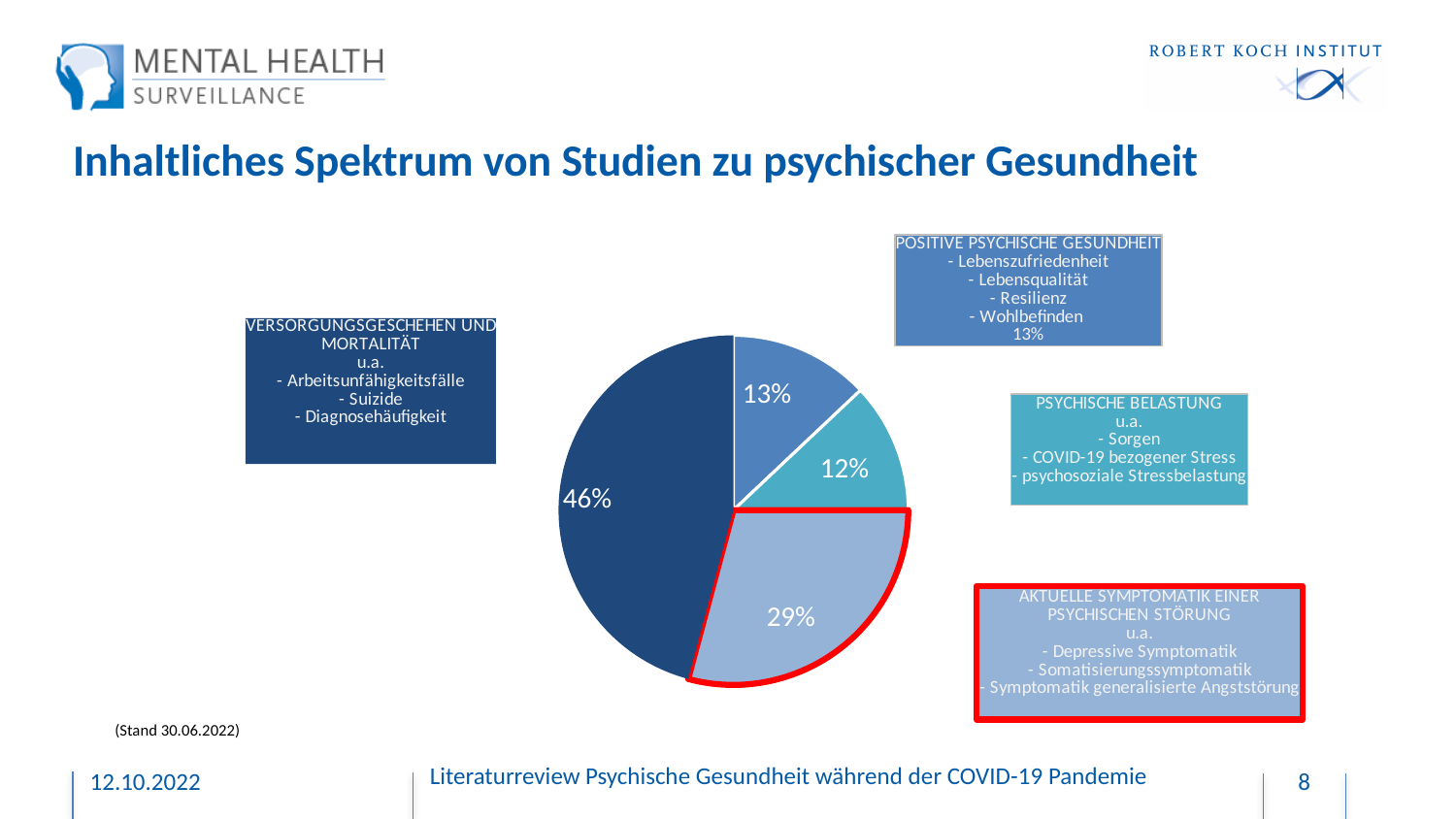
What share of the pie is labelled 'Psychische Belastung'? 12% What is the difference in percentage points between the 'Versorgungsgeschehen und Mortalität' slice and the 'Aktuelle Symptomatik einer psychischen Störung' slice? 17 percentage points Which slice is larger: 'Positive psychische Gesundheit' or 'Aktuelle Symptomatik einer psychischen Störung'? Aktuelle Symptomatik einer psychischen Störung What kind of chart is shown on the slide? pie chart How many slices does the pie chart have? 4 What is the combined share of the 'Positive psychische Gesundheit' and 'Psychische Belastung' slices? 25% Which slice of the pie chart is outlined in red? the 29% slice (Aktuelle Symptomatik einer psychischen Störung) What share of the pie is labelled 'Positive psychische Gesundheit'? 13% Which category has the largest slice of the pie? Versorgungsgeschehen und Mortalität Which category has the smallest slice of the pie? Psychische Belastung What share of the pie is labelled 'Versorgungsgeschehen und Mortalität'? 46% What share of the pie is labelled 'Aktuelle Symptomatik einer psychischen Störung'? 29%